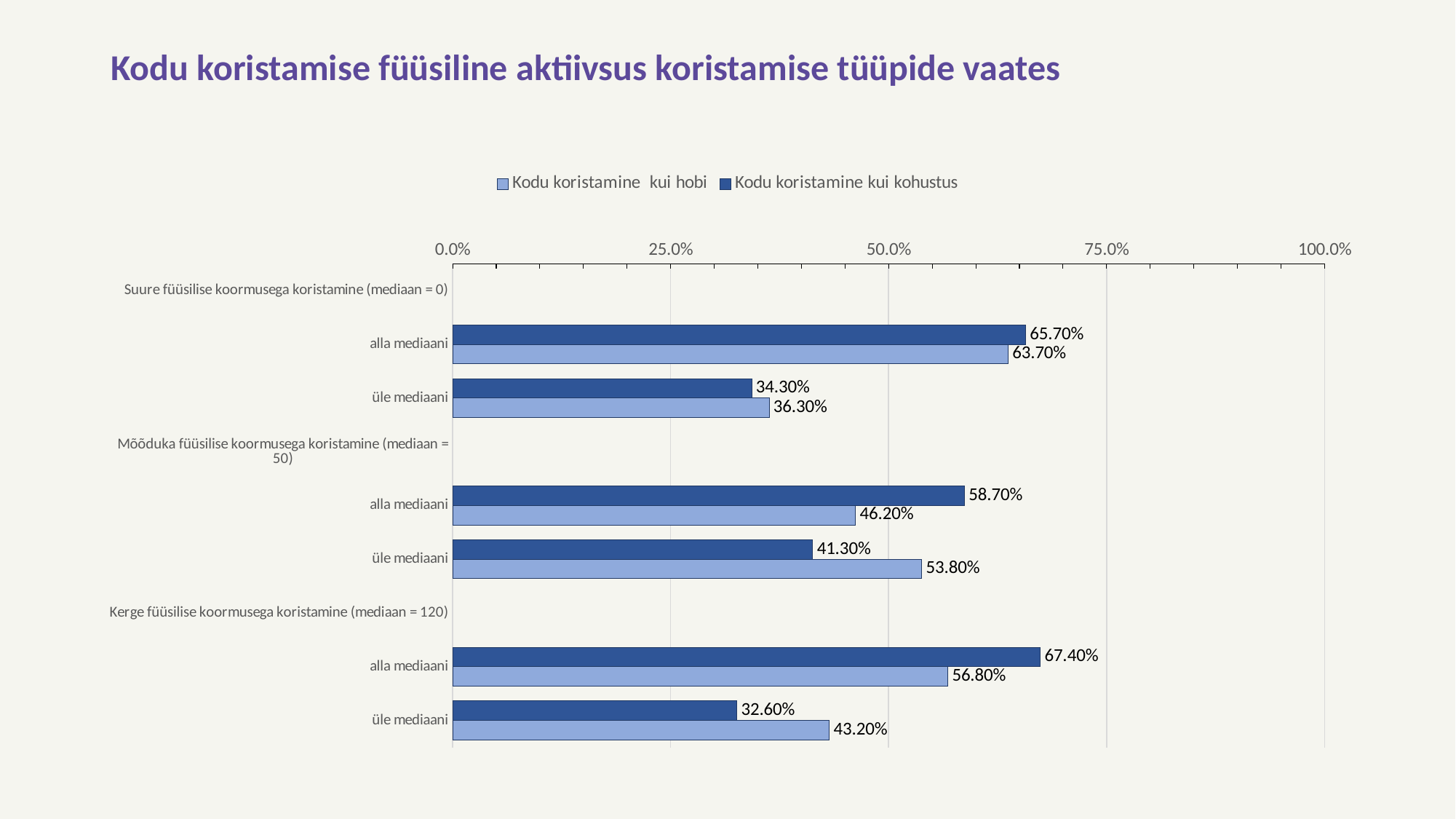
What is the difference between 'Kodu koristamine kui kohustus' and 'Kodu koristamine kui hobi' for 'alla mediaani' under 'Mõõduka füüsilise koormusega koristamine (mediaan = 50)'? 12.50% Which bar has the highest value in the chart? Kodu koristamine kui kohustus, alla mediaani under Kerge füüsilise koormusega koristamine (mediaan = 120) What is the value for 'Kodu koristamine kui kohustus' for 'üle mediaani' under 'Kerge füüsilise koormusega koristamine (mediaan = 120)'? 32.60% What is the value for 'Kodu koristamine kui hobi' for 'üle mediaani' under 'Mõõduka füüsilise koormusega koristamine (mediaan = 50)'? 53.80% What is the value for 'Kodu koristamine kui kohustus' for 'alla mediaani' under 'Suure füüsilise koormusega koristamine (mediaan = 0)'? 65.70% What is the difference between 'Kodu koristamine kui kohustus' and 'Kodu koristamine kui hobi' for 'alla mediaani' under 'Kerge füüsilise koormusega koristamine (mediaan = 120)'? 10.60% Is the value for 'Kodu koristamine kui hobi' for 'alla mediaani' under 'Suure füüsilise koormusega koristamine (mediaan = 0)' greater or less than 50.0%? greater What is the title of the chart on the slide? Kodu koristamise füüsiline aktiivsus koristamise tüüpide vaates Which bar has the lowest value in the chart? Kodu koristamine kui kohustus, üle mediaani under Kerge füüsilise koormusega koristamine (mediaan = 120) What kind of chart is shown on the slide? bar chart For 'üle mediaani' under 'Kerge füüsilise koormusega koristamine (mediaan = 120)', which series has the larger value? Kodu koristamine kui hobi How many series does the legend list? 2